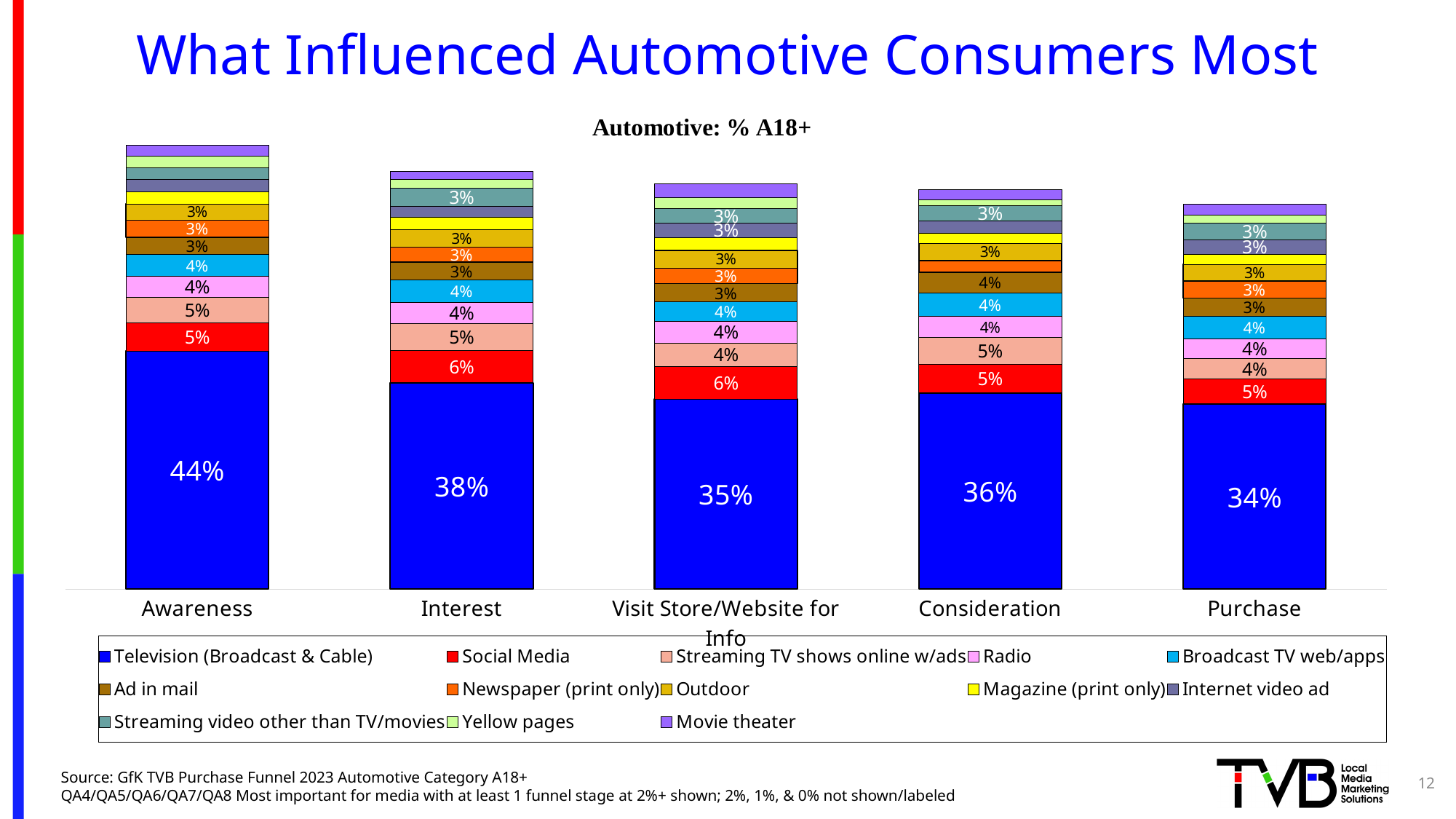
How many series does the legend list? 13 What is the Social Media value for the Interest stage? 6% What is the title printed above the chart? Automotive: % A18+ What is the Television (Broadcast & Cable) value for the Purchase stage? 34% Which funnel stage has the lowest Television (Broadcast & Cable) value? Purchase Which funnel stage has the highest Television (Broadcast & Cable) value? Awareness What is the Television (Broadcast & Cable) value for the Awareness stage? 44% How many funnel stages are shown on the x axis? 5 What is the Ad in mail value for the Consideration stage? 4% What kind of chart is shown on the slide? Stacked bar chart What is the difference between the Television (Broadcast & Cable) values for Awareness and Purchase? 10 percentage points Which stage has a larger Television (Broadcast & Cable) value, Interest or Consideration? Interest